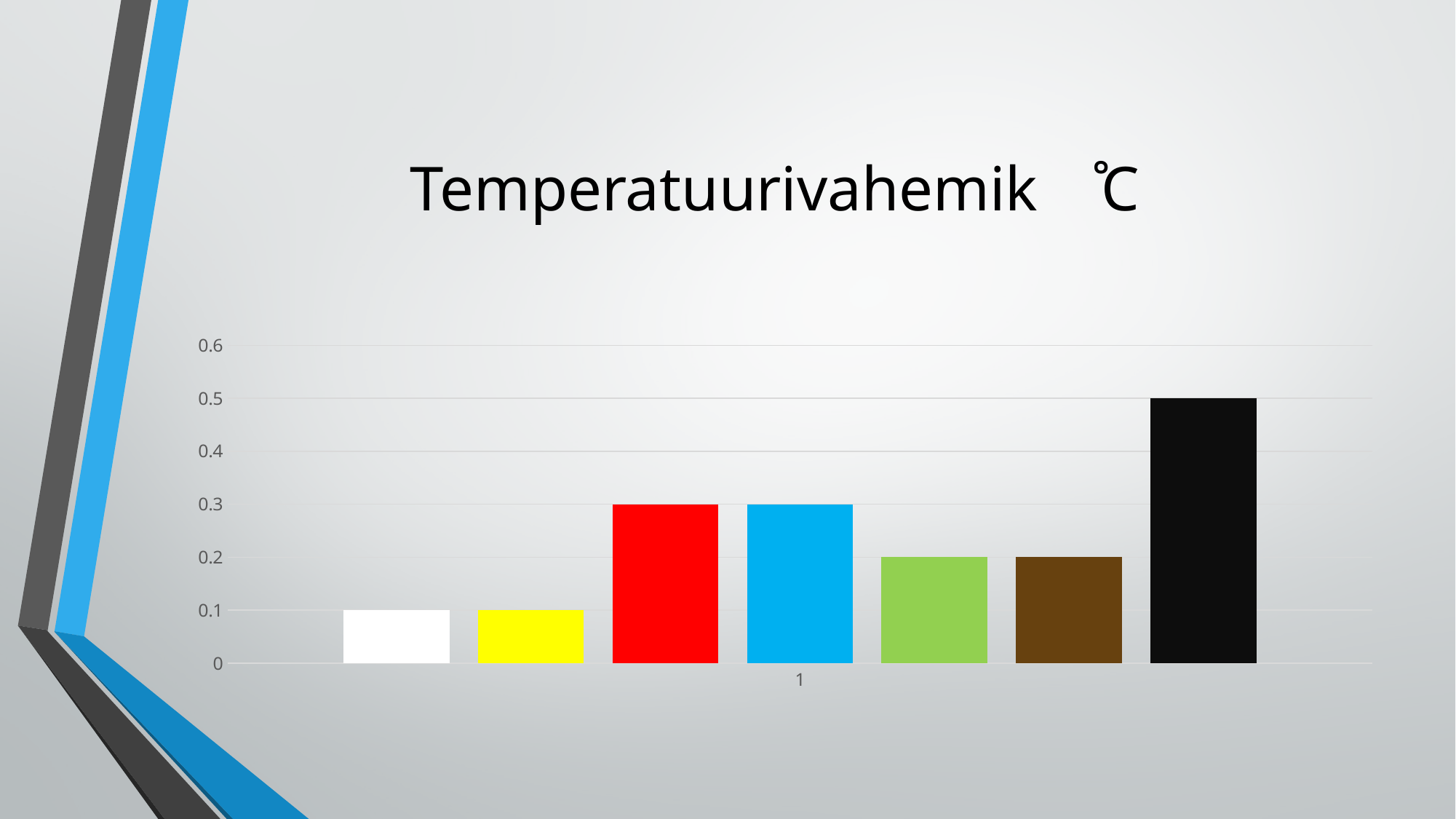
Is the value of the black bar greater or less than 0.4? greater What value does the red bar reach on the y axis? 0.3 Which is taller, the blue bar or the brown bar? the blue bar What value does the black bar reach on the y axis? 0.5 What is the title shown above the chart? Temperatuurivahemik ℃ How many bars are plotted in the chart? 7 What is the difference between the black bar and the red bar? 0.2 What value does the green bar reach on the y axis? 0.2 What is the category label shown on the x axis? 1 What value does the white bar reach on the y axis? 0.1 Which bar is the tallest in the chart? the black bar What kind of chart is shown on the slide? bar chart